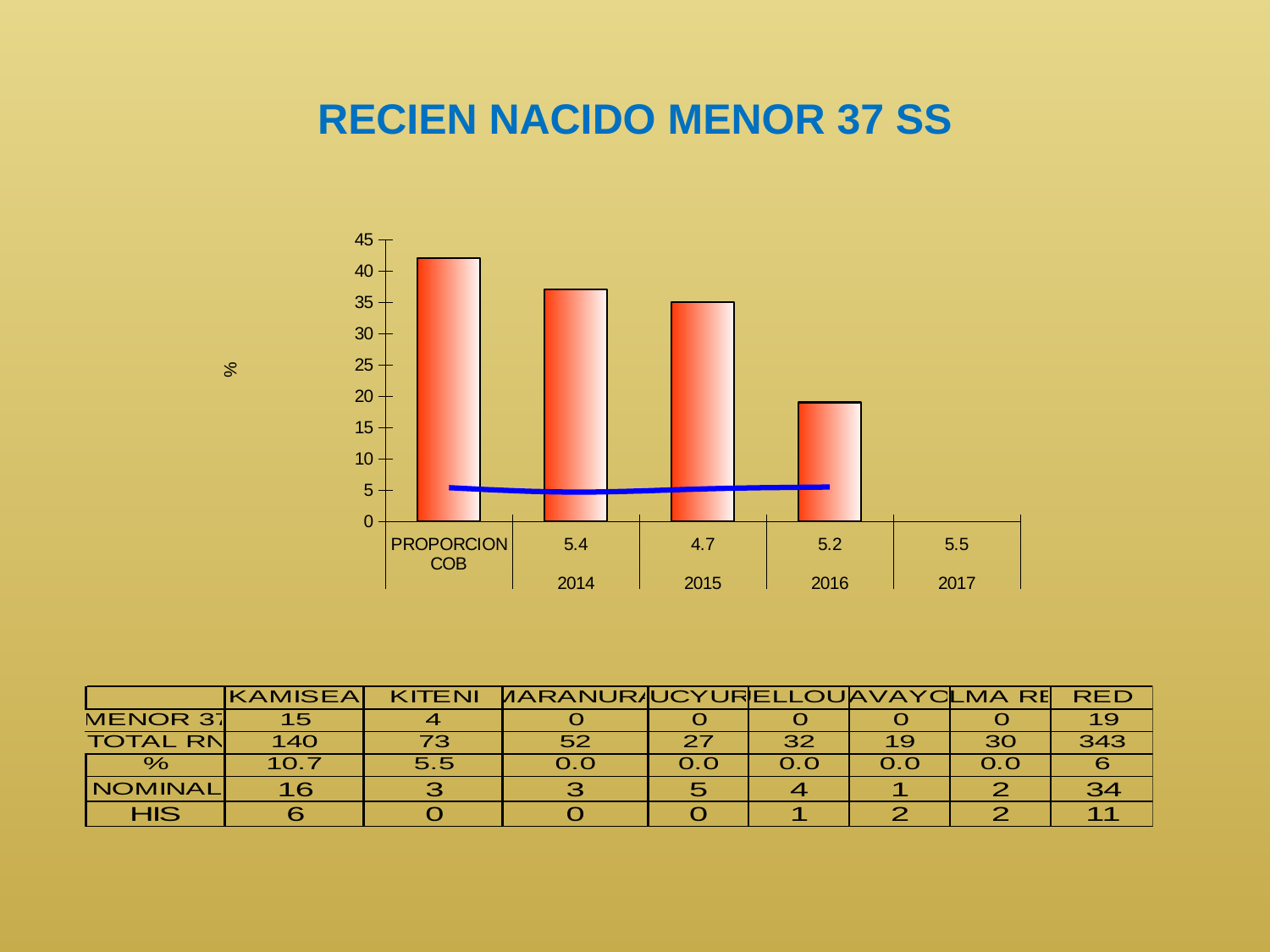
What is the PROPORCION COB value for 2015? 4.7 What is the difference between the PROPORCION COB values for 2017 and 2015? 0.8 What is the PROPORCION COB value for 2017? 5.5 What is the PROPORCION COB value for 2014? 5.4 What is the title of the chart? RECIEN NACIDO MENOR 37 SS Which year has the highest PROPORCION COB value? 2017 Which is larger, the PROPORCION COB value for 2014 or for 2016? 2014 How many years are shown on the x axis of the chart? 4 Which year has the lowest PROPORCION COB value? 2015 What kind of chart is shown on the slide? Bar chart with a line